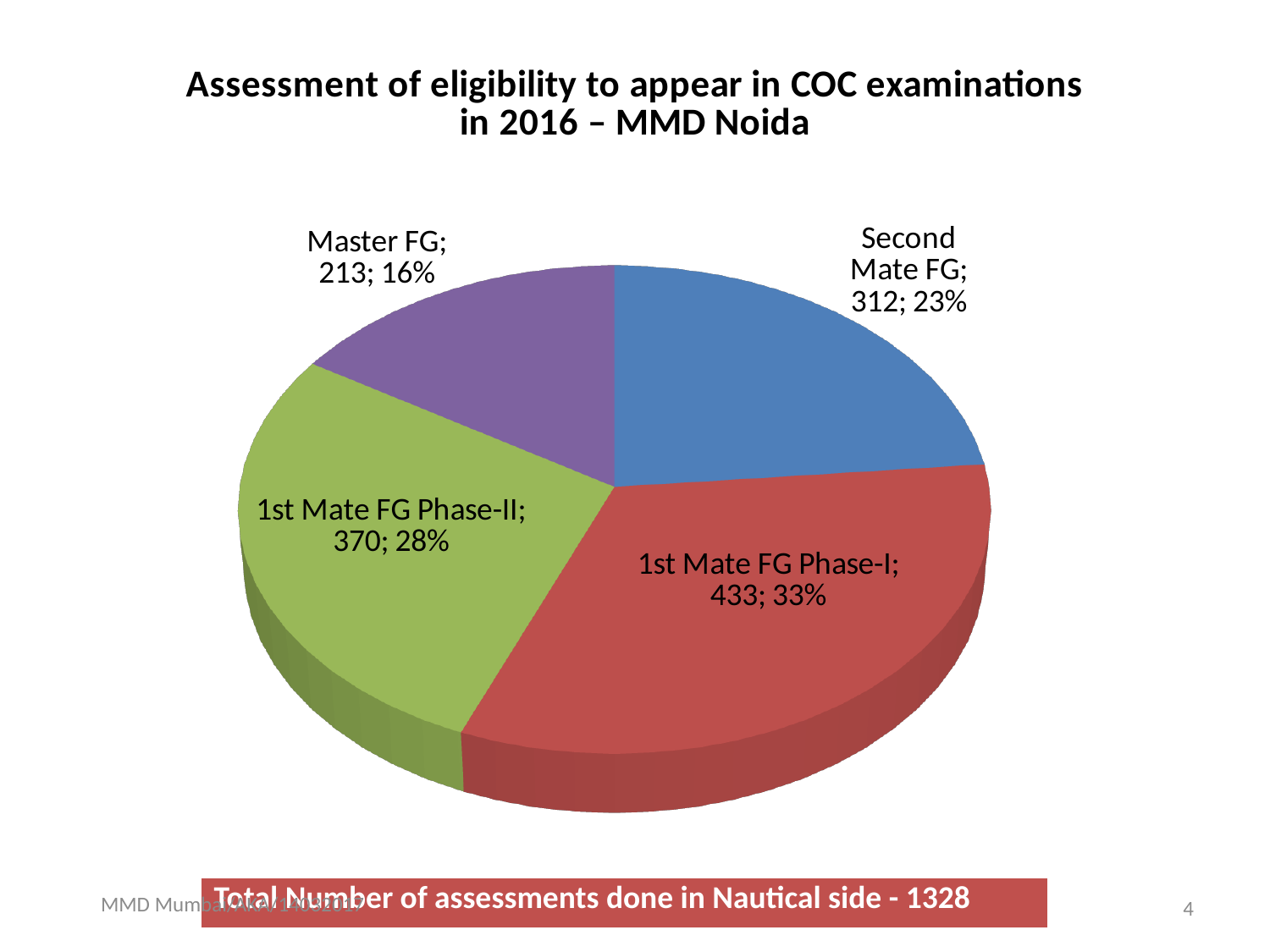
What is the difference between the values for 1st Mate FG Phase-I and 1st Mate FG Phase-II? 63 What is the value for Second Mate FG? 312 What share of the pie does 1st Mate FG Phase-I represent? 33% What is the value for Master FG? 213 Which is larger, the value for Second Mate FG or the value for Master FG? Second Mate FG Which category has the largest slice? 1st Mate FG Phase-I Which category has the smallest slice? Master FG What kind of chart is shown on the slide? pie chart What share of the pie does Second Mate FG represent? 23% How many slices does the pie chart have? 4 What is the title of the chart? Assessment of eligibility to appear in COC examinations in 2016 – MMD Noida What is the value for 1st Mate FG Phase-II? 370